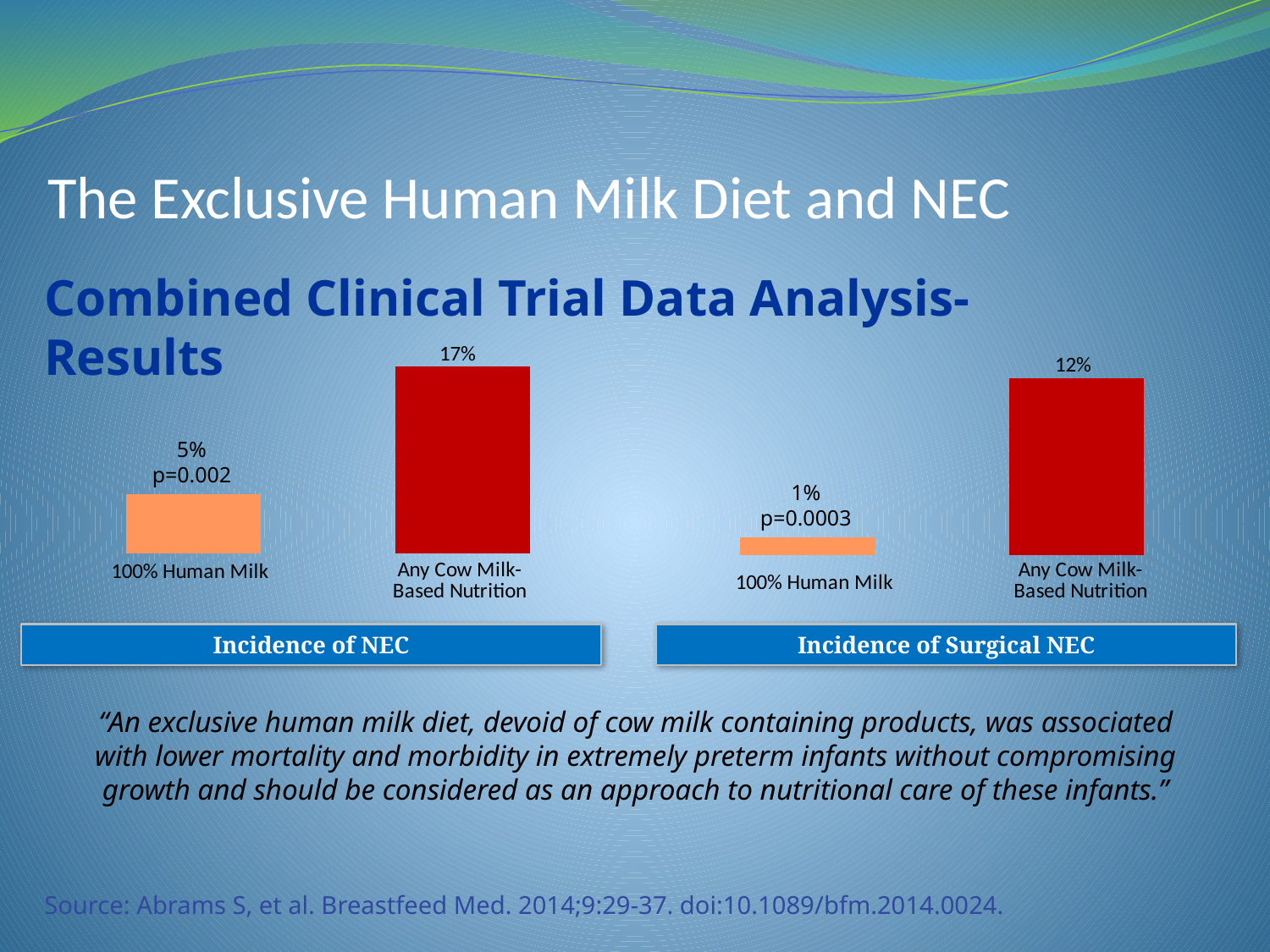
In the Incidence of NEC chart, what is the value for Any Cow Milk-Based Nutrition? 17% In the Incidence of NEC chart, which category has the highest value? Any Cow Milk-Based Nutrition In the Incidence of Surgical NEC chart, which category has the lowest value? 100% Human Milk How many categories does the Incidence of NEC chart show? 2 In the Incidence of Surgical NEC chart, what is the difference between Any Cow Milk-Based Nutrition and 100% Human Milk? 11% In the Incidence of NEC chart, what is the difference between Any Cow Milk-Based Nutrition and 100% Human Milk? 12% In the Incidence of Surgical NEC chart, which is larger: 100% Human Milk or Any Cow Milk-Based Nutrition? Any Cow Milk-Based Nutrition In the Incidence of Surgical NEC chart, what is the value for 100% Human Milk? 1% In the Incidence of NEC chart, what p-value is printed above the 100% Human Milk bar? p=0.002 In the Incidence of NEC chart, what is the value for 100% Human Milk? 5% What kind of chart is the Incidence of Surgical NEC chart? Bar chart In the Incidence of Surgical NEC chart, what is the value for Any Cow Milk-Based Nutrition? 12%